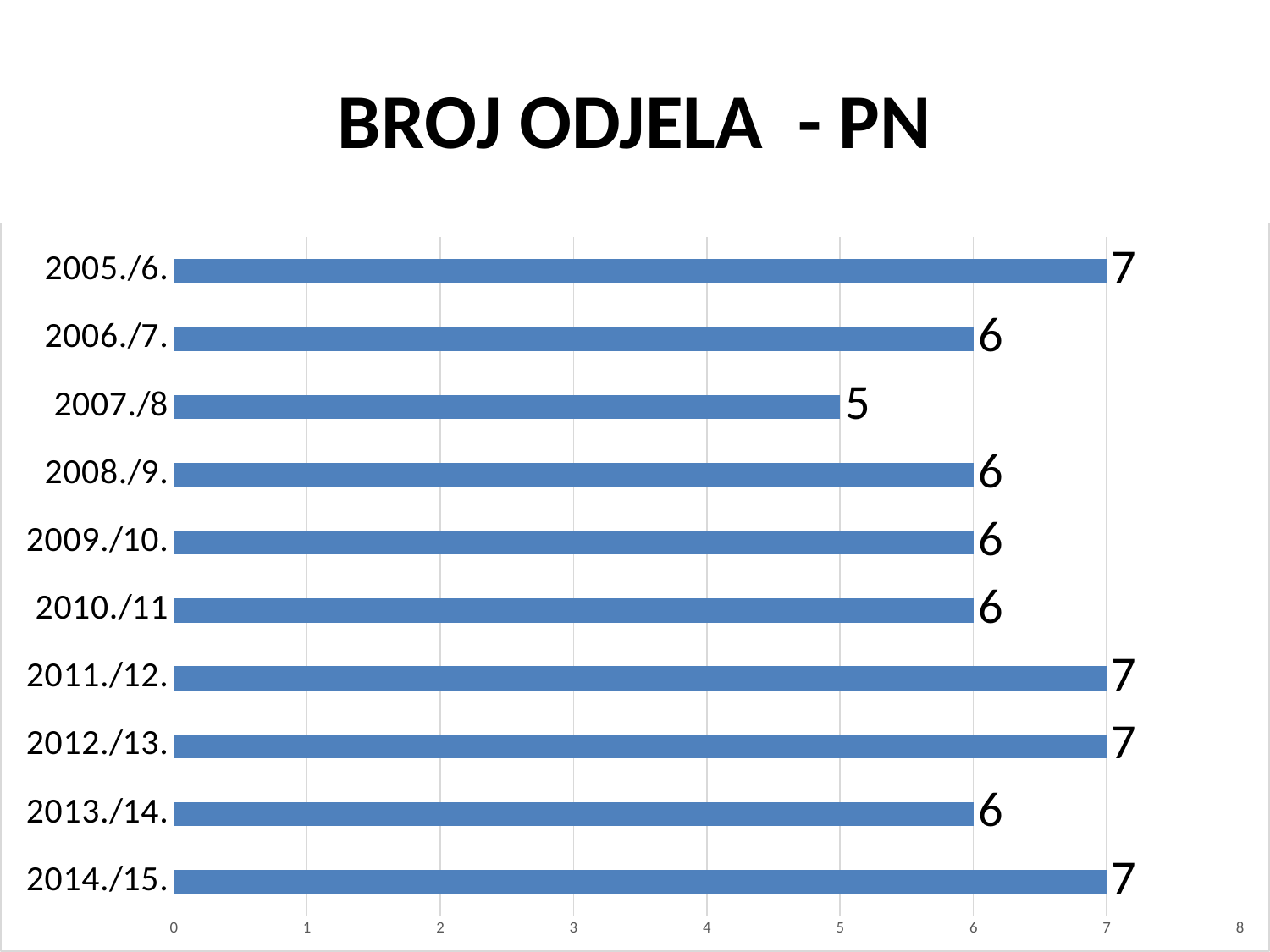
Which category has the lowest value? 2007./8 What is the value for 2007./8? 5 Which is larger, the value for 2011./12. or the value for 2010./11? 2011./12. What is the value for 2005./6.? 7 What is the difference between the values for 2012./13. and 2013./14.? 1 How many categories are shown in the chart? 10 What is the difference between the values for 2005./6. and 2007./8? 2 What is the value for 2013./14.? 6 What kind of chart is shown on the slide? bar chart What is the title of the chart? BROJ ODJELA - PN How many categories have a value of 7? 4 Is the value for 2007./8 greater or less than 6? less